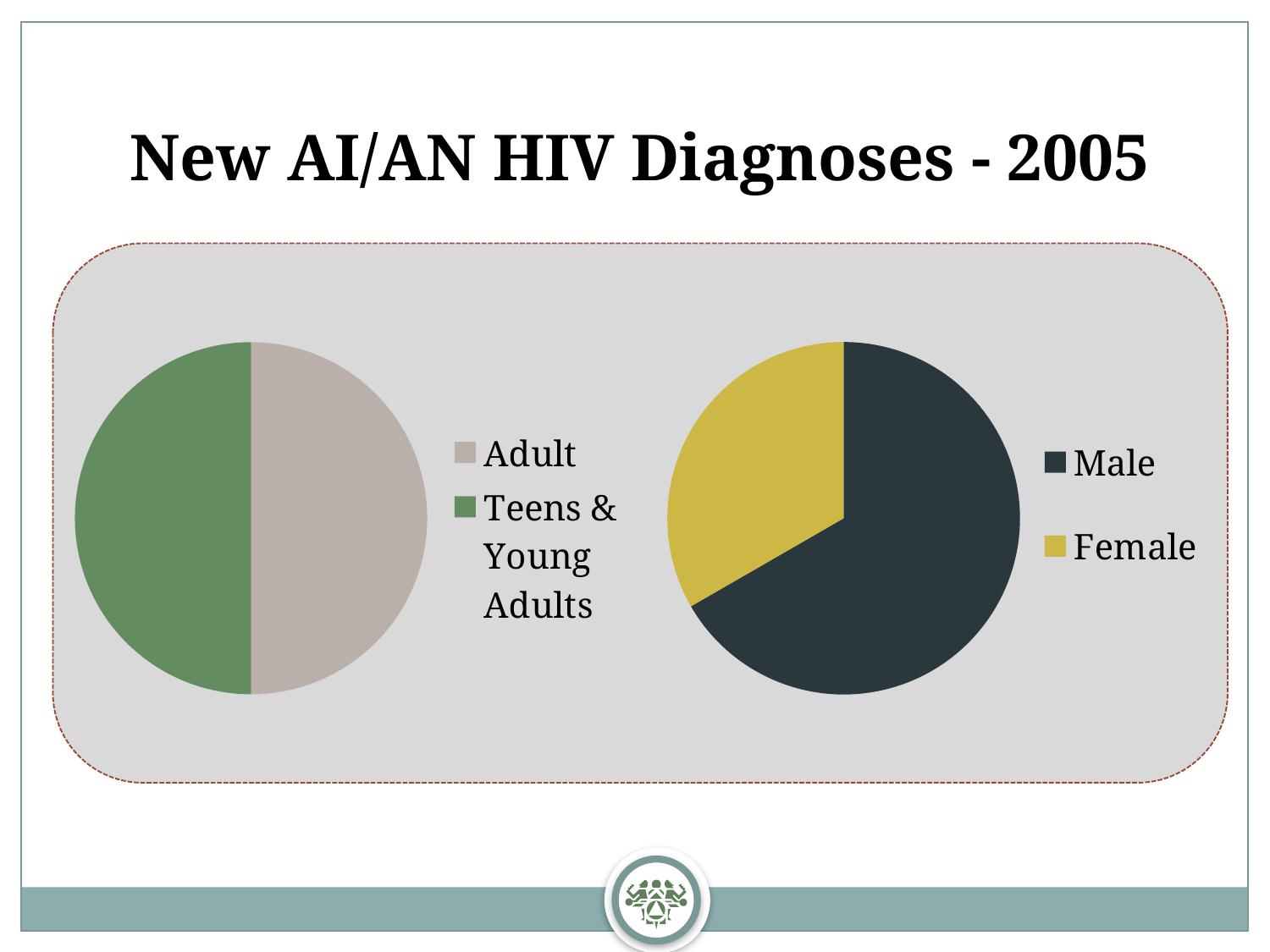
How many slices does the right pie chart have? 2 What kind of chart is the right chart on the slide? pie chart How many entries does the legend of the left pie chart list? 2 How many slices does the left pie chart have? 2 What kind of chart is the left chart on the slide? pie chart What is the title of the slide containing the two pie charts? New AI/AN HIV Diagnoses - 2005 In the right pie chart, which category has the largest slice? Male How many entries does the legend of the right pie chart list? 2 In the left pie chart, what colour represents Teens & Young Adults? green In the right pie chart, which slice is larger, Male or Female? Male In the right pie chart, which category has the smallest slice? Female